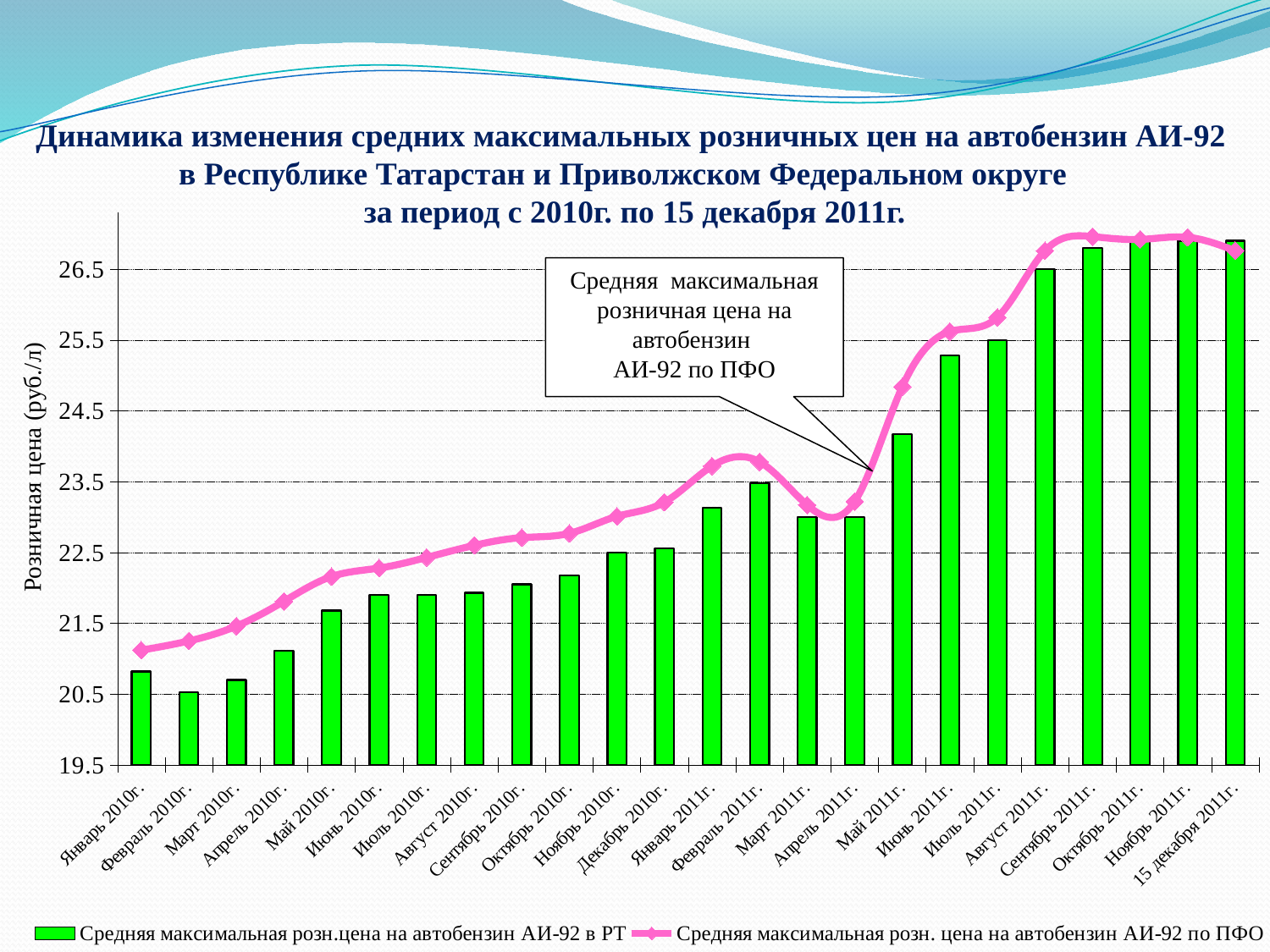
What kind of chart is shown on the slide? A combined bar and line chart Which bar is taller: Май 2011г. or Апрель 2011г.? Май 2011г. Is the line value for Май 2011г. (price in ПФО) greater or less than 24.5? greater What is the unit shown on the y axis label? руб./л Is the bar value for Январь 2010г. (price in RT) greater or less than 21.5? less What colour are the bars representing the average maximum retail price of AI-92 in RT? Green Which month has the lowest bar for the average maximum retail price of AI-92 in RT? Февраль 2010г. Is the bar value for Июнь 2011г. (price in RT) greater or less than 25.5? less Overall, do the prices rise or fall from January 2010 to 15 December 2011? Rise How many series does the legend list? 2 How many time periods (categories) are shown on the x axis? 24